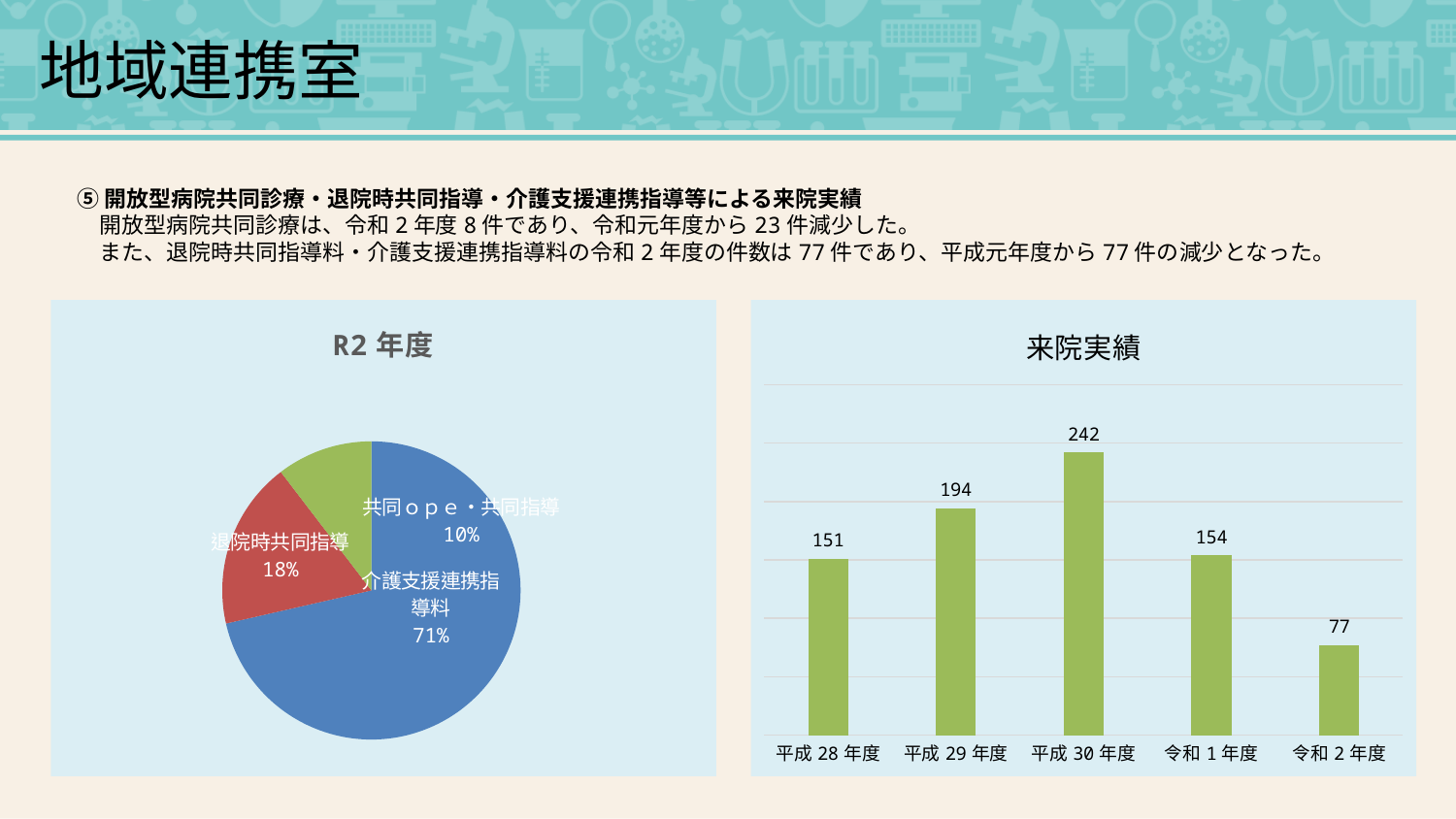
In the 来院実績 chart, which year has the highest value? 平成 30 年度 In the 来院実績 chart, which year has the lowest value? 令和 2 年度 In the 来院実績 chart, what is the value for 平成 30 年度? 242 In the 来院実績 chart, which is larger: the value for 平成 28 年度 or 令和 1 年度? 令和 1 年度 What kind of chart is the 来院実績 chart? bar chart What kind of chart is the R2 年度 chart? pie chart In the R2 年度 pie chart, what share does 介護支援連携指導料 have? 71% In the 来院実績 chart, what is the value for 令和 2 年度? 77 In the R2 年度 pie chart, what share does 退院時共同指導 have? 18% In the 来院実績 chart, what is the difference between the values for 平成 30 年度 and 令和 1 年度? 88 How many bars are in the 来院実績 chart? 5 In the 来院実績 chart, do the values rise or fall from 令和 1 年度 to 令和 2 年度? fall